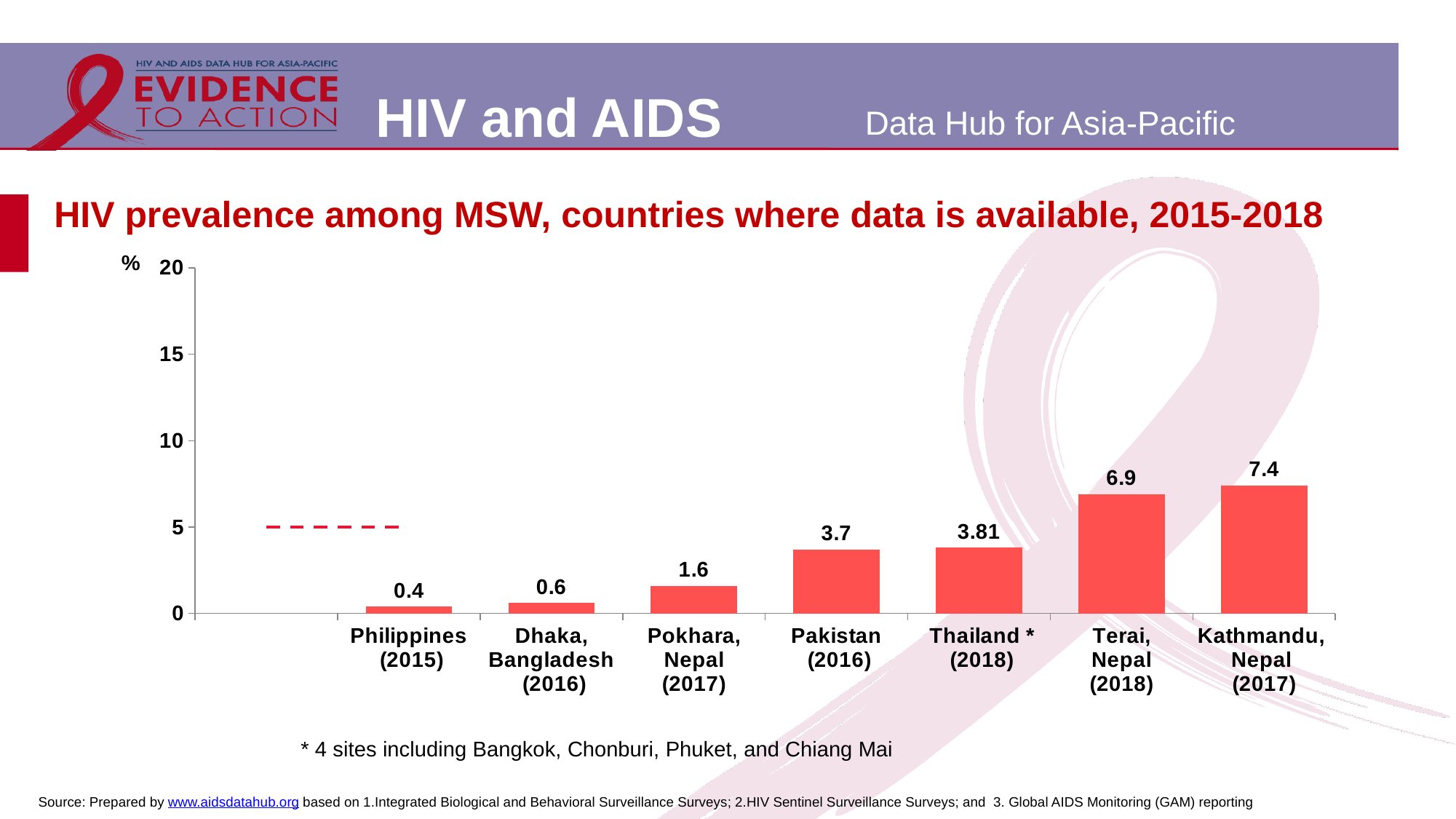
Which category has the lowest HIV prevalence among MSW? Philippines (2015) What is the HIV prevalence among MSW for Thailand * (2018)? 3.81 Which has a higher HIV prevalence among MSW: Pakistan (2016) or Dhaka, Bangladesh (2016)? Pakistan (2016) What is the HIV prevalence among MSW for Philippines (2015)? 0.4 How many categories are shown on the x axis of the chart? 7 Do the values rise or fall from left to right along the x axis? rise Is the value for Terai, Nepal (2018) greater or less than 5? greater What is the HIV prevalence among MSW for Kathmandu, Nepal (2017)? 7.4 What is the title of the chart? HIV prevalence among MSW, countries where data is available, 2015-2018 What is the difference in HIV prevalence between Terai, Nepal (2018) and Pokhara, Nepal (2017)? 5.3 Which category has the highest HIV prevalence among MSW? Kathmandu, Nepal (2017) What kind of chart is shown on the slide? bar chart